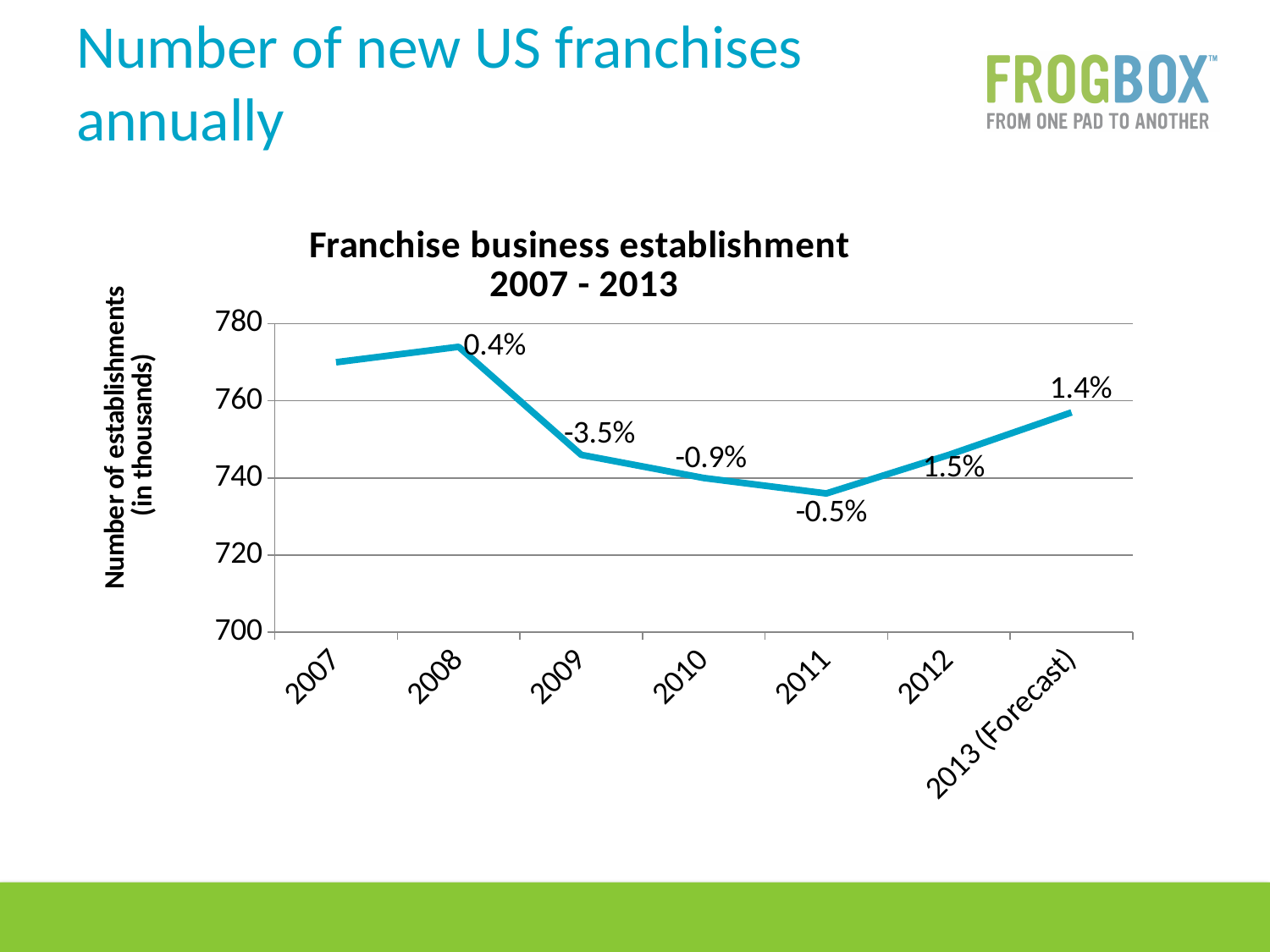
Which year has the highest number of establishments? 2008 Which is larger, the value for 2007 or the value for 2009? 2007 What percentage label is shown next to the 2013 (Forecast) data point? 1.4% What is the title of the chart? Franchise business establishment 2007 - 2013 What percentage label is shown next to the 2011 data point? -0.5% How many years (data points) are plotted on the chart? 7 What kind of chart is shown on the slide? line chart Is the value for 2008 greater or less than 760? greater What percentage label is shown next to the 2009 data point? -3.5% Which year has the lowest number of establishments? 2011 Is the value for 2011 greater or less than 740? less Do the values rise or fall from 2008 to 2011? fall